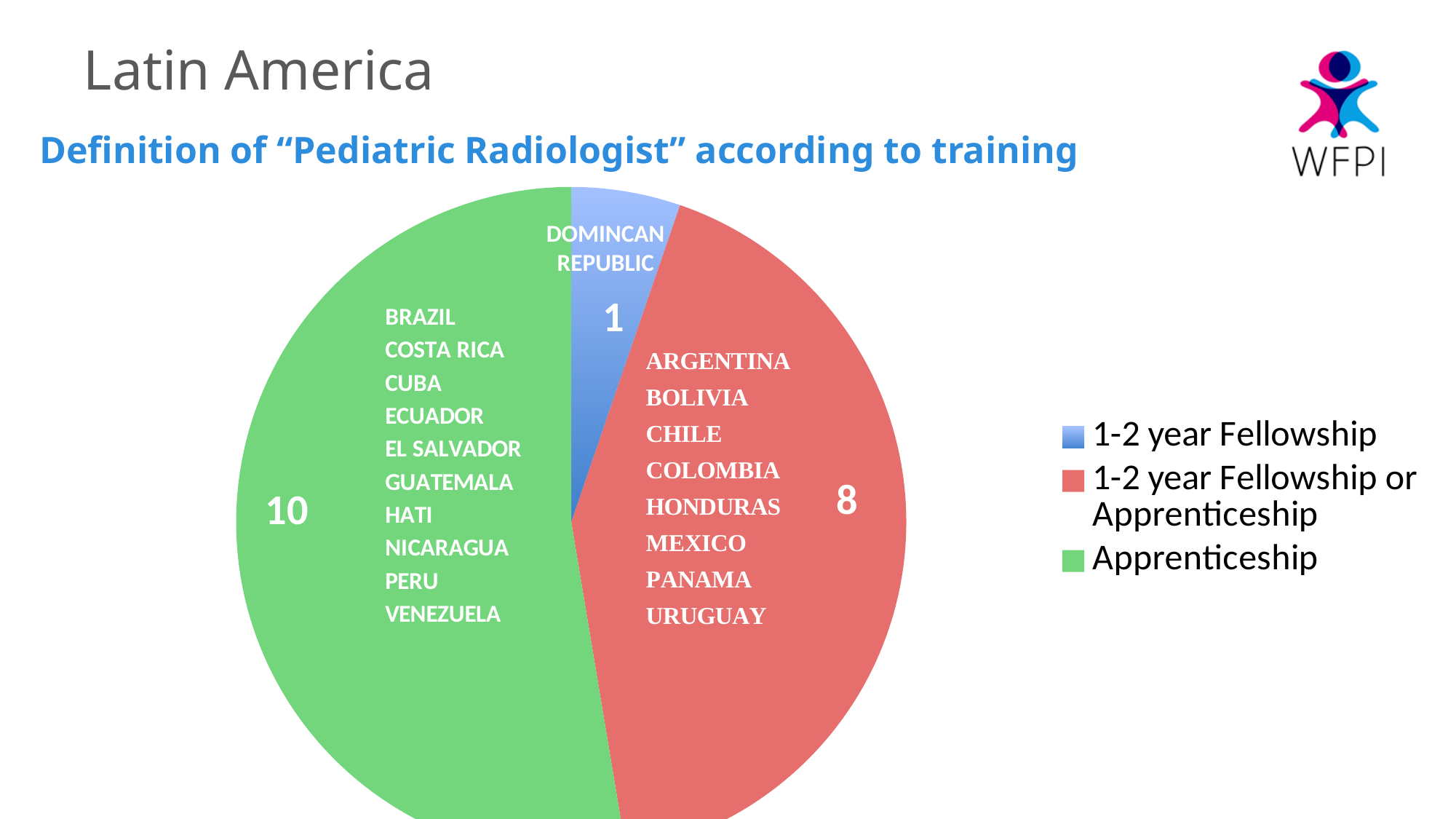
Which is larger: the Apprenticeship slice or the 1-2 year Fellowship or Apprenticeship slice? Apprenticeship What is the total of all the slice values in the pie chart? 19 Which category has the largest slice of the pie? Apprenticeship What type of chart is shown on the slide? Pie chart What is the value for the 1-2 year Fellowship or Apprenticeship slice? 8 How many entries does the legend list? 3 What is the difference between the Apprenticeship value and the 1-2 year Fellowship or Apprenticeship value? 2 What is the value for the 1-2 year Fellowship slice? 1 Which country is listed in the 1-2 year Fellowship slice? Dominican Republic How many slices does the pie chart have? 3 What is the value for the Apprenticeship slice? 10 Which category has the smallest slice of the pie? 1-2 year Fellowship